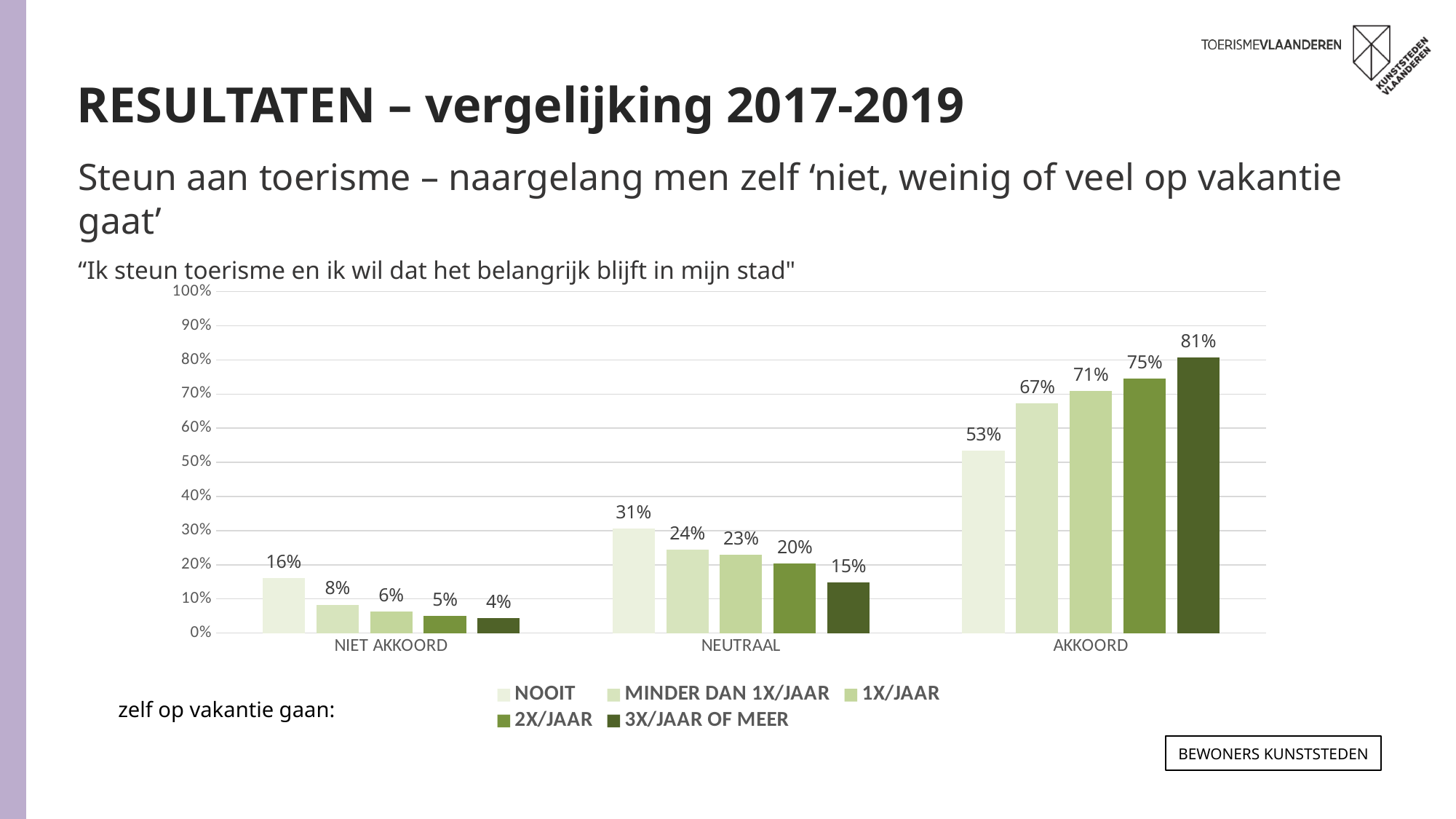
What is the difference between the NOOIT and MINDER DAN 1X/JAAR values in the NEUTRAAL category? 7% How many series does the legend list? 5 Which series has the highest value in the AKKOORD category? 3X/JAAR OF MEER Within the AKKOORD category, do the values rise or fall from NOOIT to 3X/JAAR OF MEER? Rise What is the value for 3X/JAAR OF MEER in the NEUTRAAL category? 15% What kind of chart is shown on the slide? Bar chart Which series has the lowest value in the NIET AKKOORD category? 3X/JAAR OF MEER What is the difference between the 3X/JAAR OF MEER and NOOIT values in the AKKOORD category? 28% What is the value for NOOIT in the AKKOORD category? 53% How many categories are shown on the x axis? 3 Which is larger: the 2X/JAAR value in NEUTRAAL or the NOOIT value in NIET AKKOORD? 2X/JAAR in NEUTRAAL What is the value for 1X/JAAR in the NIET AKKOORD category? 6%